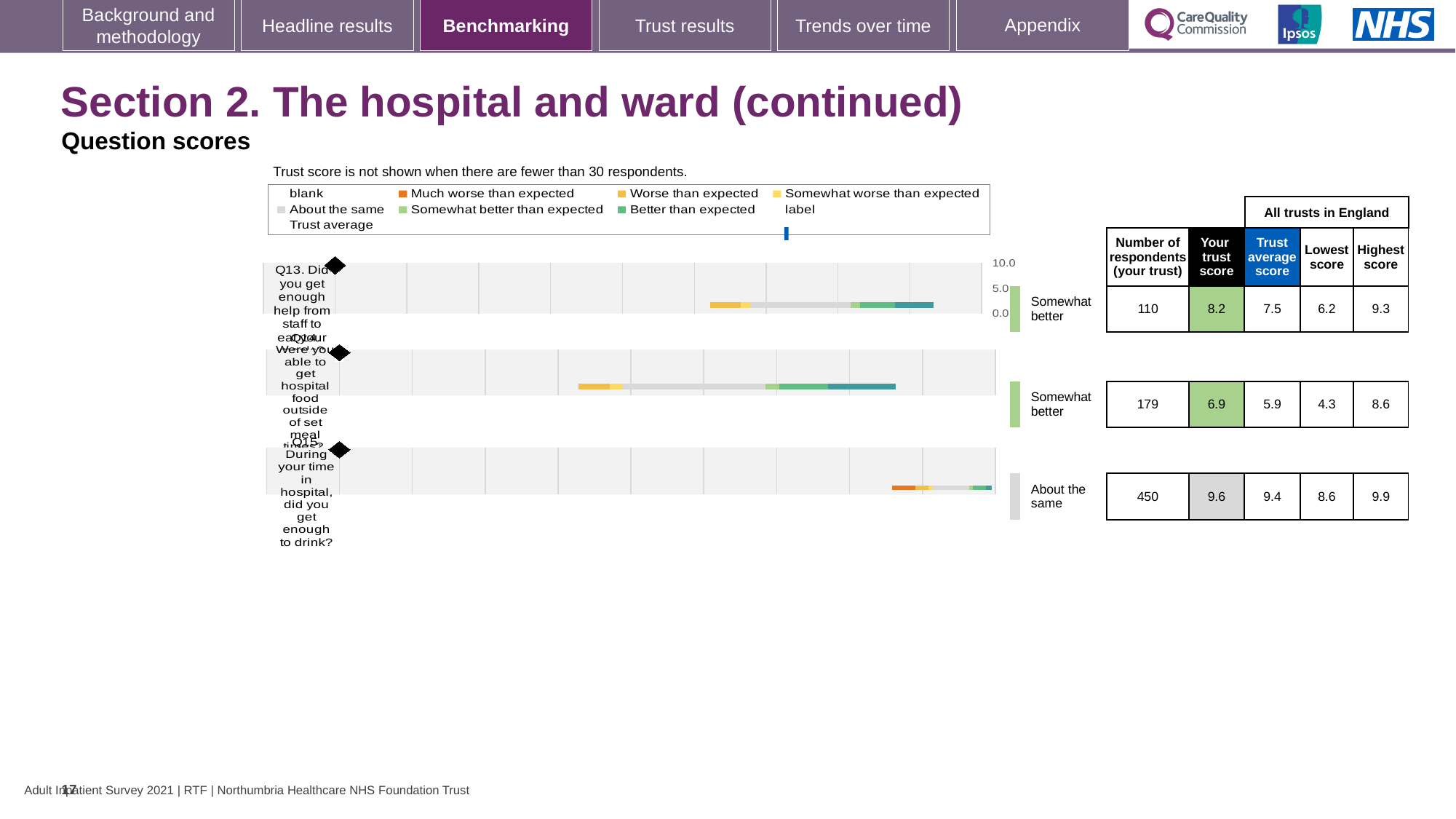
By how much does the trust score for Q13 exceed the trust average score for Q13? 0.7 What kind of chart is used to show the question scores? Bar chart What is the highest score among all trusts in England for Q13? 9.3 Which question has the highest trust score for this trust? Q15 What is the lowest score among all trusts in England for Q14? 4.3 Which question has the fewest respondents at this trust? Q13 What benchmark category is shown next to Q15's bar? About the same For Q15, which is larger: the trust score or the trust average score? Trust score What is the trust average score across all trusts in England for Q15 (did you get enough to drink?)? 9.4 What is the trust score for Q13 (Did you get enough help from staff to eat your meals?)? 8.2 How many respondents answered Q14 (Were you able to get hospital food outside of set meal times?) at this trust? 179 How many questions are plotted in the chart? 3